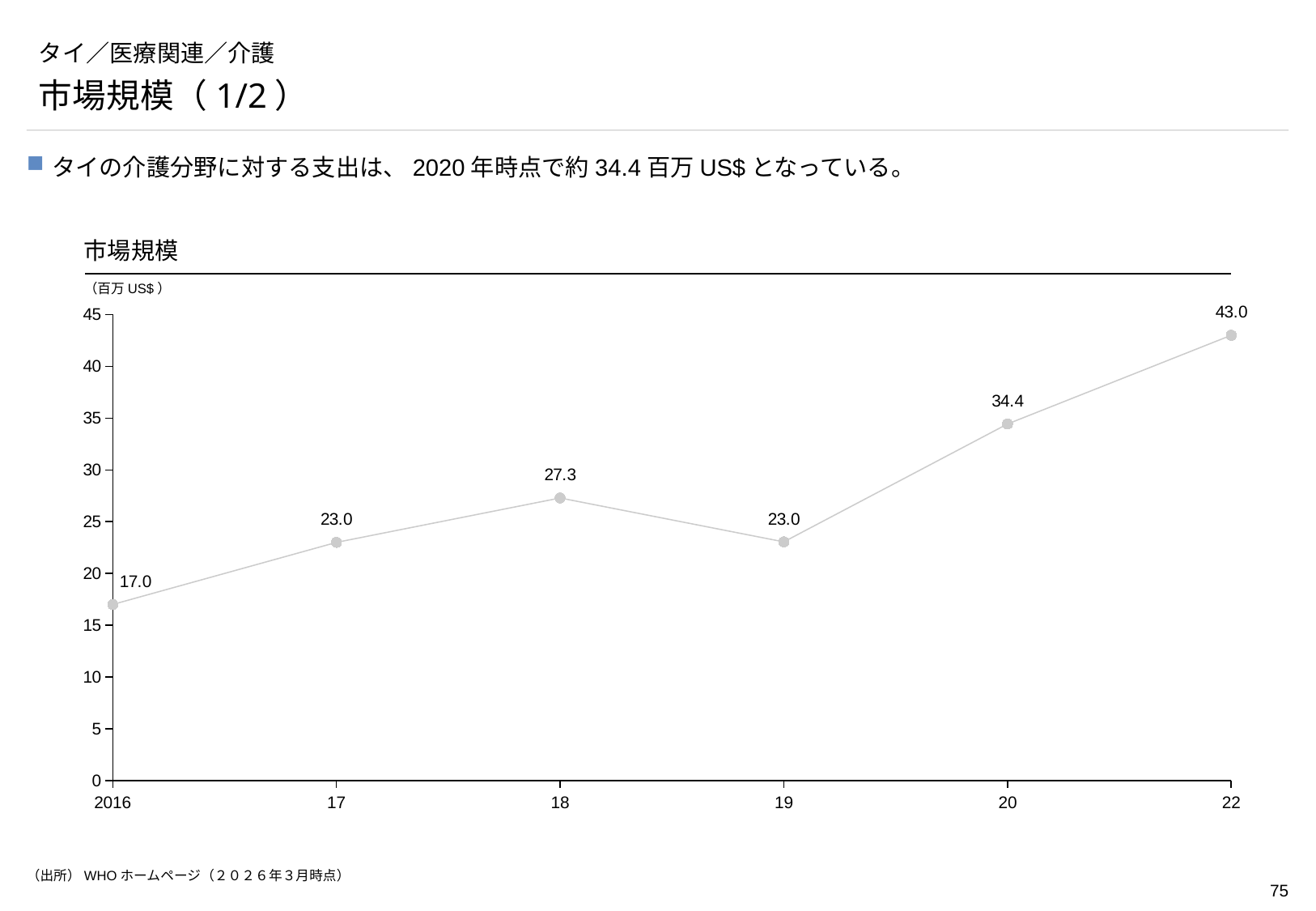
What is the market size value for 2022 (labelled 22)? 43.0 What kind of chart is shown on the slide? line chart Is the value for 20 greater or less than 30? greater Which year has the highest market size value? 22 What is the difference between the values for 18 and 17? 4.3 Which is larger, the value for 18 or the value for 19? 18 What is the market size value for 2016? 17.0 What unit is shown for the chart's values? 百万 US$ What is the market size value for 2020 (labelled 20)? 34.4 How many data points are plotted on the chart? 6 Which year has the lowest market size value? 2016 What is the difference between the values for 22 and 20? 8.6